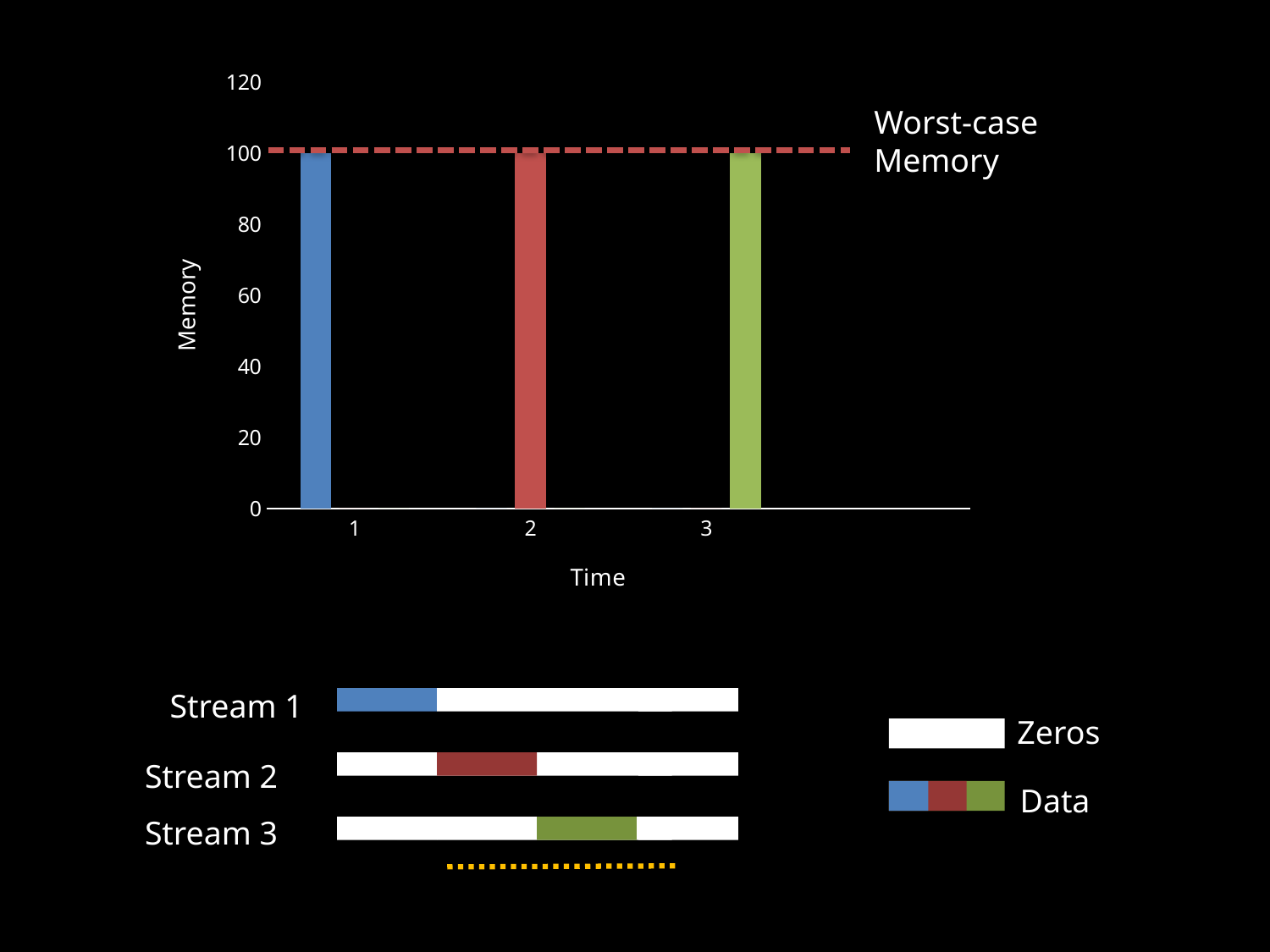
How many bars are plotted in the chart? 3 What is the memory value for time 1? 100 What type of chart is shown on the slide? bar chart What does the dashed horizontal line at 100 represent? Worst-case Memory What is the memory value for time 3? 100 What is the difference between the values for time 1 and time 3? 0 What is the memory value for time 2? 100 Is the value for time 3 greater or less than 120? less Is the value for time 2 greater or less than 80? greater Do the values rise, fall, or stay the same from time 1 to time 3? stay the same What is the title of the vertical axis? Memory